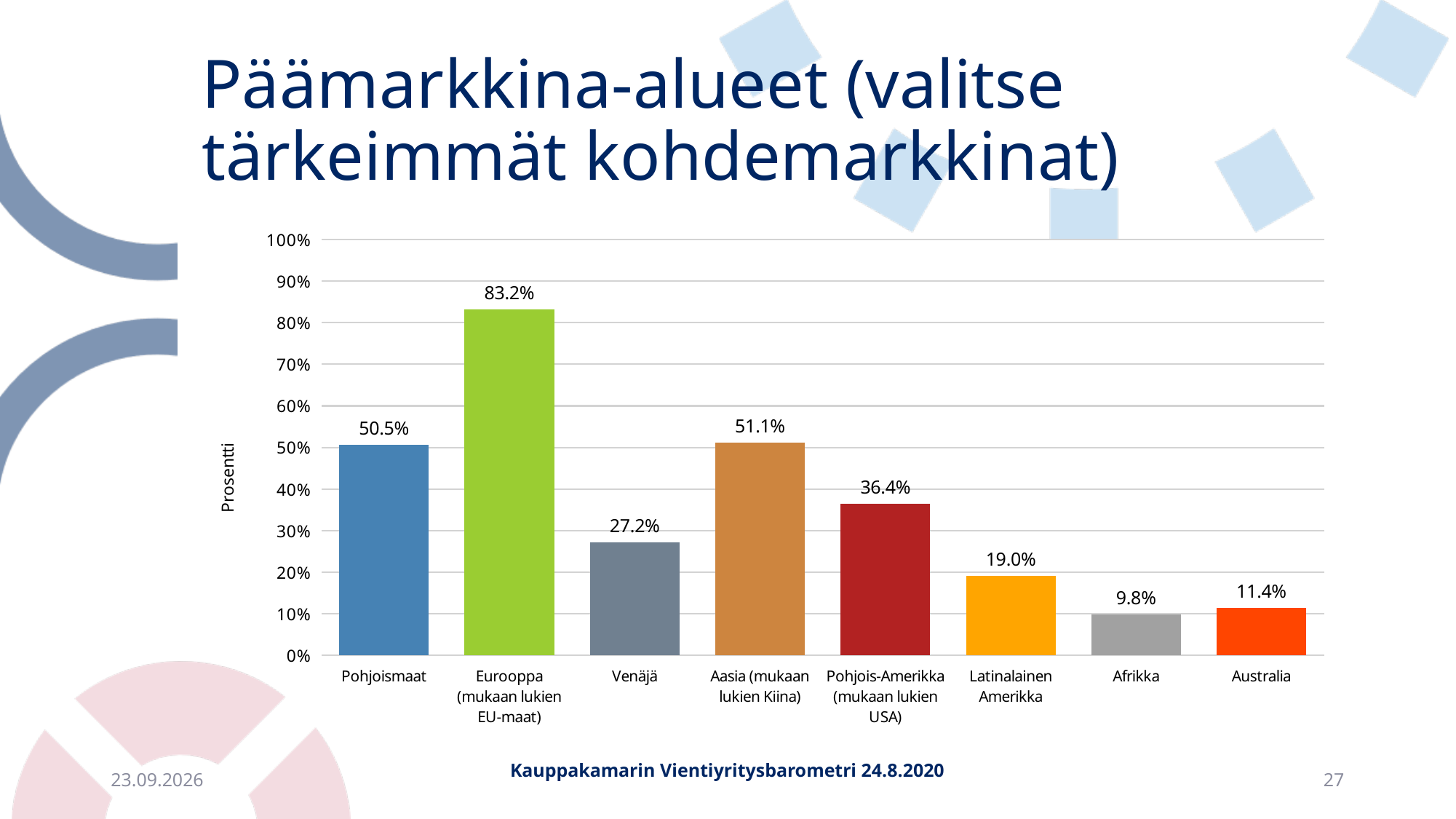
What is the difference between the values for Eurooppa (mukaan lukien EU-maat) and Pohjoismaat? 32.7% Is the value for Aasia (mukaan lukien Kiina) greater or less than 40%? greater What is the value for Eurooppa (mukaan lukien EU-maat)? 83.2% What is the label of the vertical axis? Prosentti Which is larger, the value for Australia or the value for Afrikka? Australia Which category has the highest value? Eurooppa (mukaan lukien EU-maat) What is the value for Latinalainen Amerikka? 19.0% What kind of chart is shown on the slide? bar chart How many categories are shown on the x axis? 8 What is the value for Venäjä? 27.2% What is the difference between the values for Pohjois-Amerikka (mukaan lukien USA) and Venäjä? 9.2% Which category has the lowest value? Afrikka